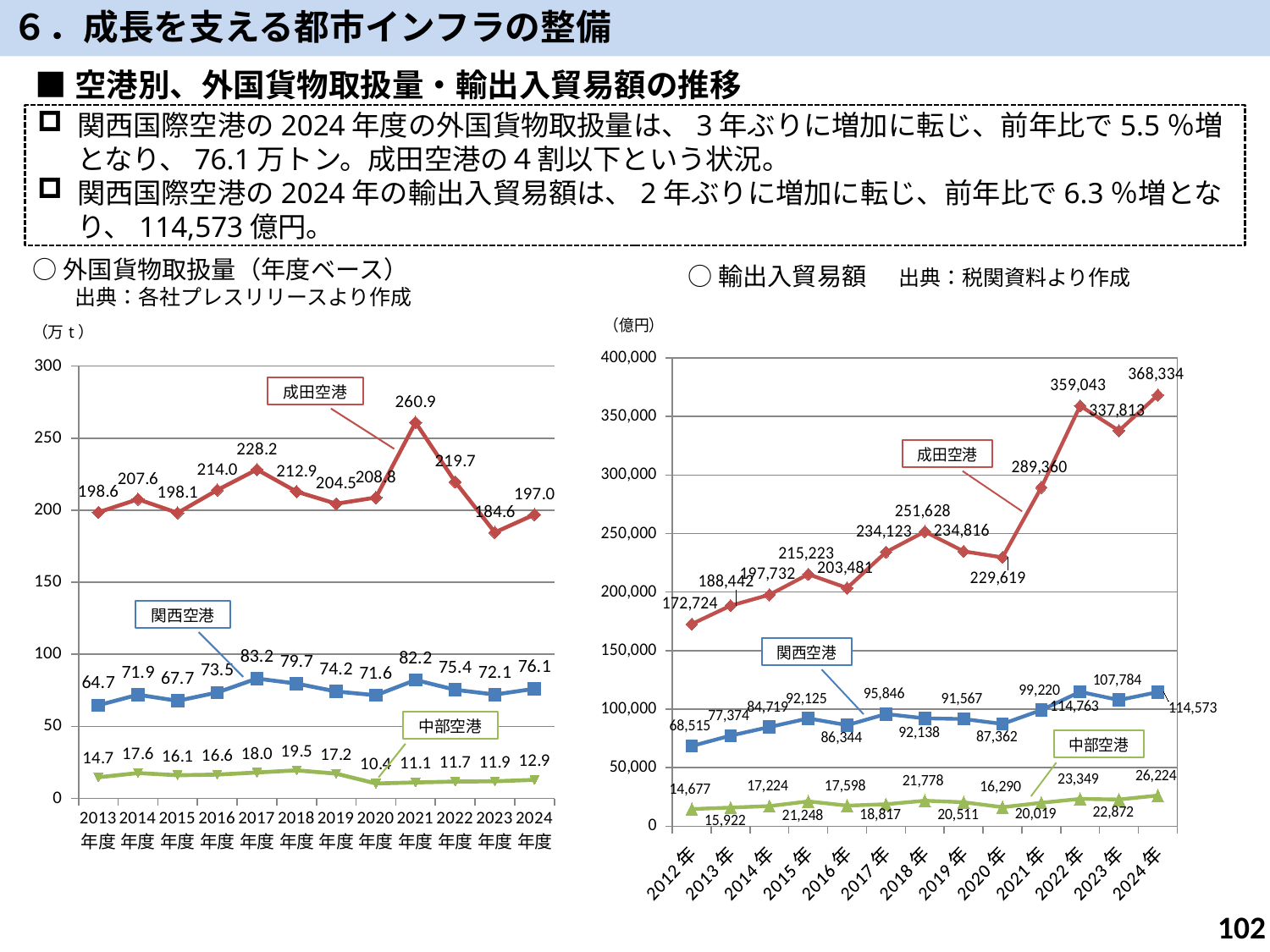
In the left chart (外国貨物取扱量), what is the difference between the 成田空港 and 関西空港 values in 2024年度? 120.9 In the right chart (輸出入貿易額), what is the value for 成田空港 in 2024年? 368,334 In the left chart (外国貨物取扱量), how many fiscal years are shown on the x axis? 12 In the right chart (輸出入貿易額), which is larger for 関西空港: the 2022年 value or the 2024年 value? 2022年 In the left chart (外国貨物取扱量), what is the value for 成田空港 in 2021年度? 260.9 In the left chart (外国貨物取扱量), in which year is the 関西空港 value highest? 2017年度 In the right chart (輸出入貿易額), what is the value for 中部空港 in 2012年? 14,677 In the left chart (外国貨物取扱量), what is the value for 関西空港 in 2024年度? 76.1 What kind of chart is the right chart (輸出入貿易額)? line chart In the left chart (外国貨物取扱量), in which year is the 中部空港 value lowest? 2020年度 In the right chart (輸出入貿易額), what is the unit shown on the y axis? 億円 In the right chart (輸出入貿易額), is the 成田空港 value in 2023年 greater or less than 300,000? greater